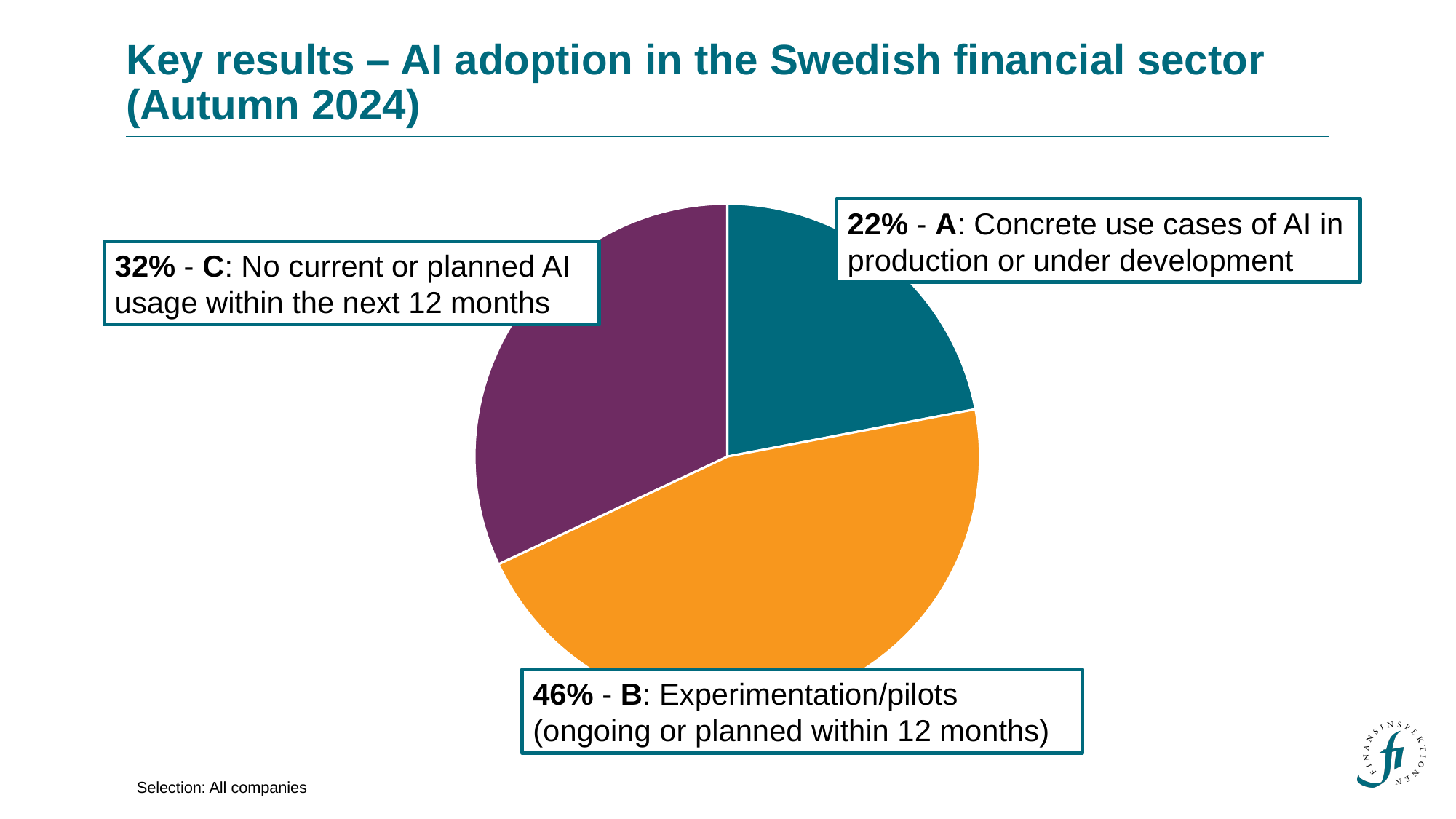
How many slices does the pie chart have? 3 What is the difference in percentage points between category B and category C? 14 percentage points Which is larger, the share for category C or the share for category A? Category C What is the difference in percentage points between category C and category A? 10 percentage points What share of companies falls into category A (Concrete use cases of AI in production or under development)? 22% What share of companies falls into category B (Experimentation/pilots)? 46% Which category has the largest share of the pie? B: Experimentation/pilots (ongoing or planned within 12 months) What selection of companies does the chart cover, according to the note at the bottom of the slide? All companies Which category has the smallest share of the pie? A: Concrete use cases of AI in production or under development What colour is the slice for category B (Experimentation/pilots)? Orange What share of companies falls into category C (No current or planned AI usage within the next 12 months)? 32% What kind of chart is shown on the slide? Pie chart